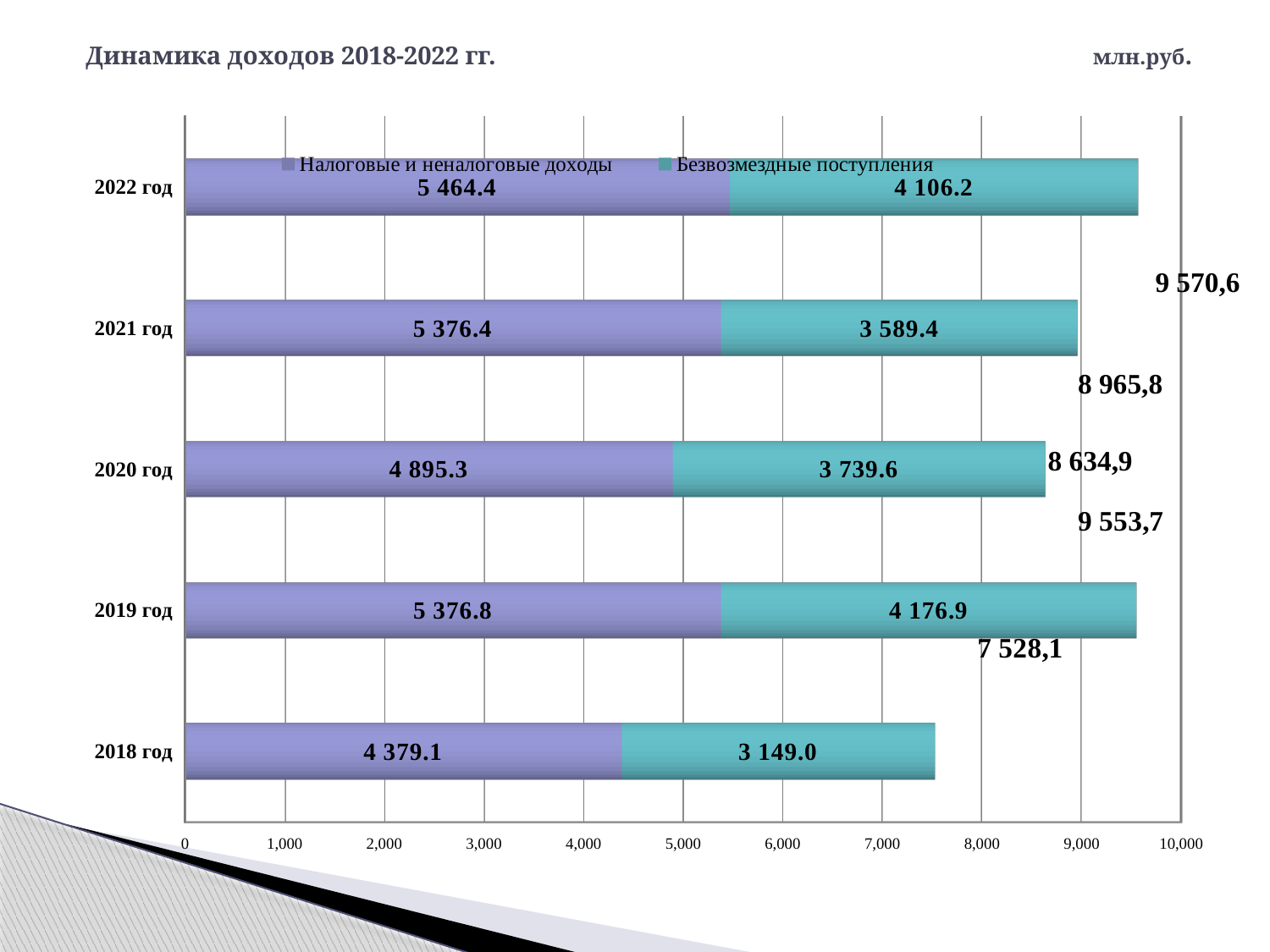
What is the value of Налоговые и неналоговые доходы for 2022 год? 5 464.4 What is the title of the chart? Динамика доходов 2018-2022 гг. How many series does the legend list? 2 What kind of chart is shown on the slide? Stacked bar chart What is the value of Безвозмездные поступления for 2020 год? 3 739.6 Which is larger: Безвозмездные поступления in 2021 год or in 2020 год? 2020 год How many years are shown on the chart? 5 What is the total of the stacked bar for 2018 год? 7 528,1 What is the value of Безвозмездные поступления for 2018 год? 3 149.0 Which year has the lowest value of Налоговые и неналоговые доходы? 2018 год What is the difference between Налоговые и неналоговые доходы in 2022 год and 2018 год? 1 085.3 Which year has the highest value of Безвозмездные поступления? 2019 год